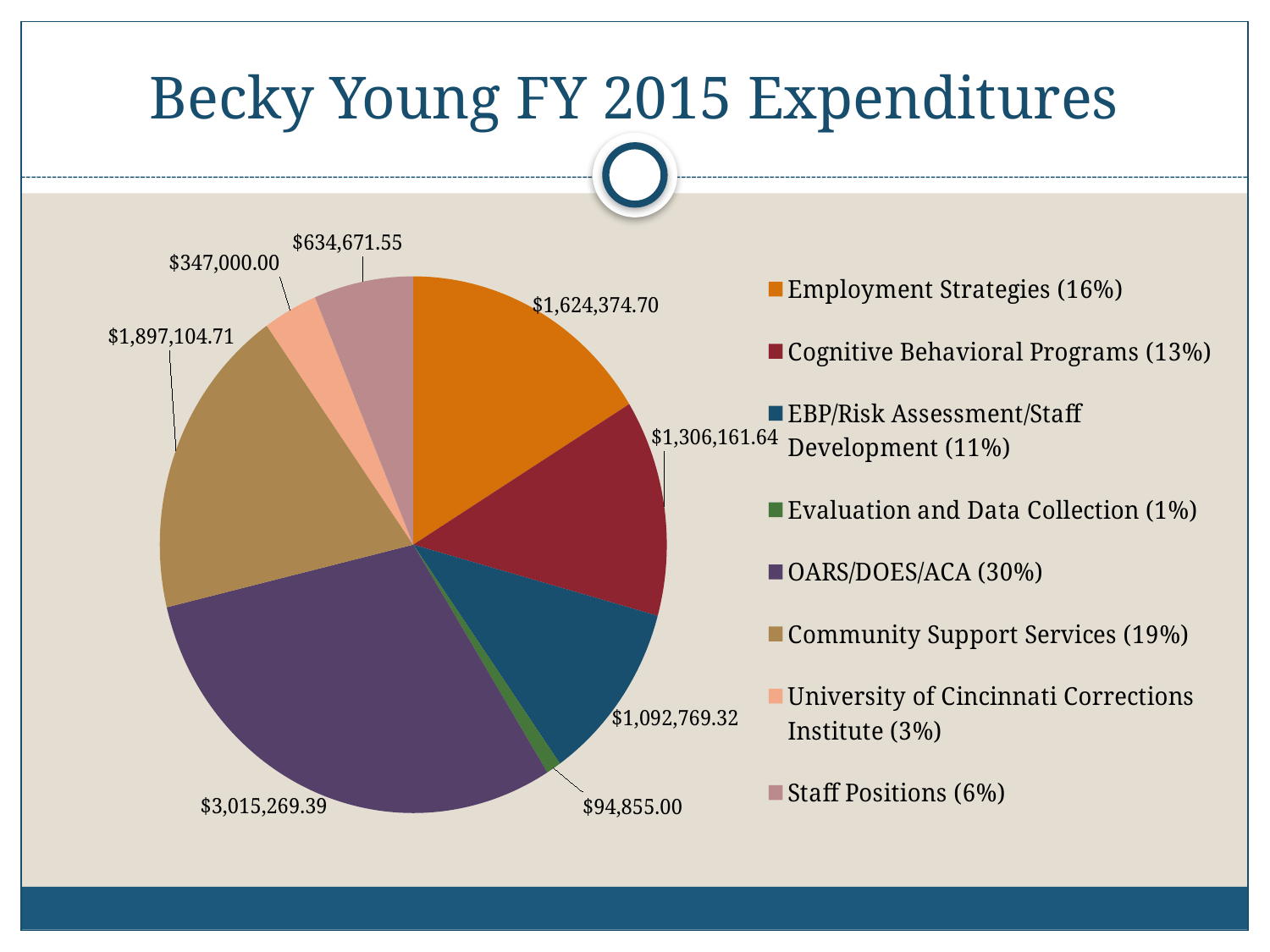
Which category has the largest expenditure? OARS/DOES/ACA What is the expenditure value for Employment Strategies? $1,624,374.70 What is the expenditure value for OARS/DOES/ACA? $3,015,269.39 How many categories are shown in the pie chart? 8 What is the difference between the Staff Positions and University of Cincinnati Corrections Institute expenditures? $287,671.55 Which category has the smallest expenditure? Evaluation and Data Collection Which is larger, the expenditure for Cognitive Behavioral Programs or for EBP/Risk Assessment/Staff Development? Cognitive Behavioral Programs What is the expenditure value for Evaluation and Data Collection? $94,855.00 What is the expenditure value for University of Cincinnati Corrections Institute? $347,000.00 What type of chart is shown on the slide? Pie chart What is the difference between the OARS/DOES/ACA and Community Support Services expenditures? $1,118,164.68 What share of the pie does Community Support Services represent? 19%